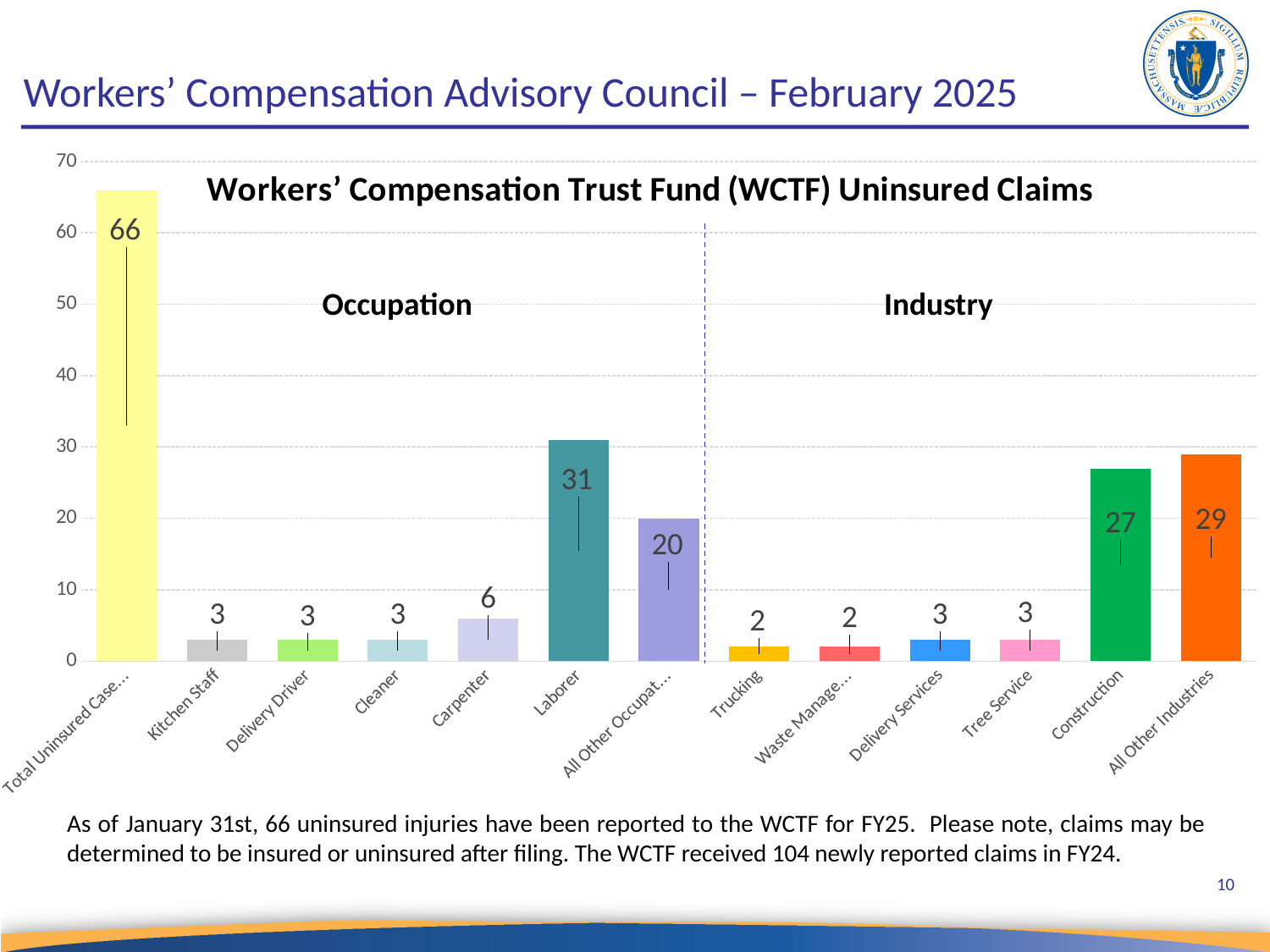
What is the value for Carpenter? 6 Which is larger, the value for All Other Industries or the value for Construction? All Other Industries What kind of chart is shown on the slide? Bar chart How many bars are plotted in the chart? 13 Which occupation category has the highest value? Laborer What is the value for Construction? 27 Is the value for Laborer greater or less than 30? greater What is the value for Laborer? 31 What is the value for Trucking? 2 What is the title of the chart? Workers' Compensation Trust Fund (WCTF) Uninsured Claims What is the value for All Other Industries? 29 What is the difference between the values for Laborer and Construction? 4